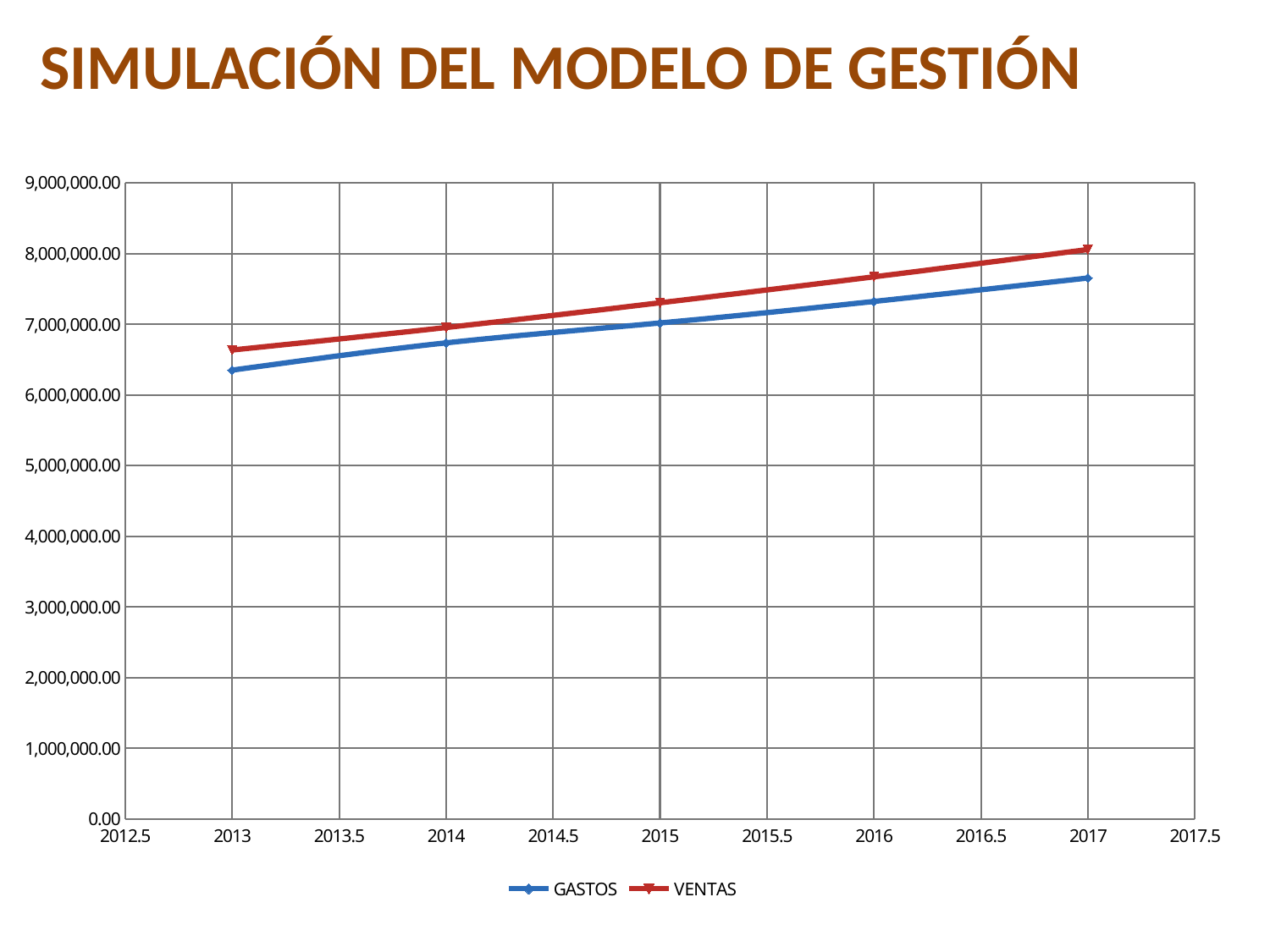
How many series does the legend list? 2 Do the VENTAS values rise or fall from 2013 to 2017? Rise What is the title of the slide containing the chart? SIMULACIÓN DEL MODELO DE GESTIÓN What kind of chart is shown on the slide? Line chart In which year is the GASTOS value lowest? 2013 Is the value for GASTOS in 2013 greater or less than 7,000,000.00? less What are the names of the two series in the legend? GASTOS and VENTAS How many data points does the GASTOS series have? 5 In 2017, which series has the larger value, GASTOS or VENTAS? VENTAS Is the value for VENTAS in 2016 greater or less than 7,000,000.00? greater Do the GASTOS values rise or fall from 2013 to 2017? Rise In which year is the VENTAS value highest? 2017